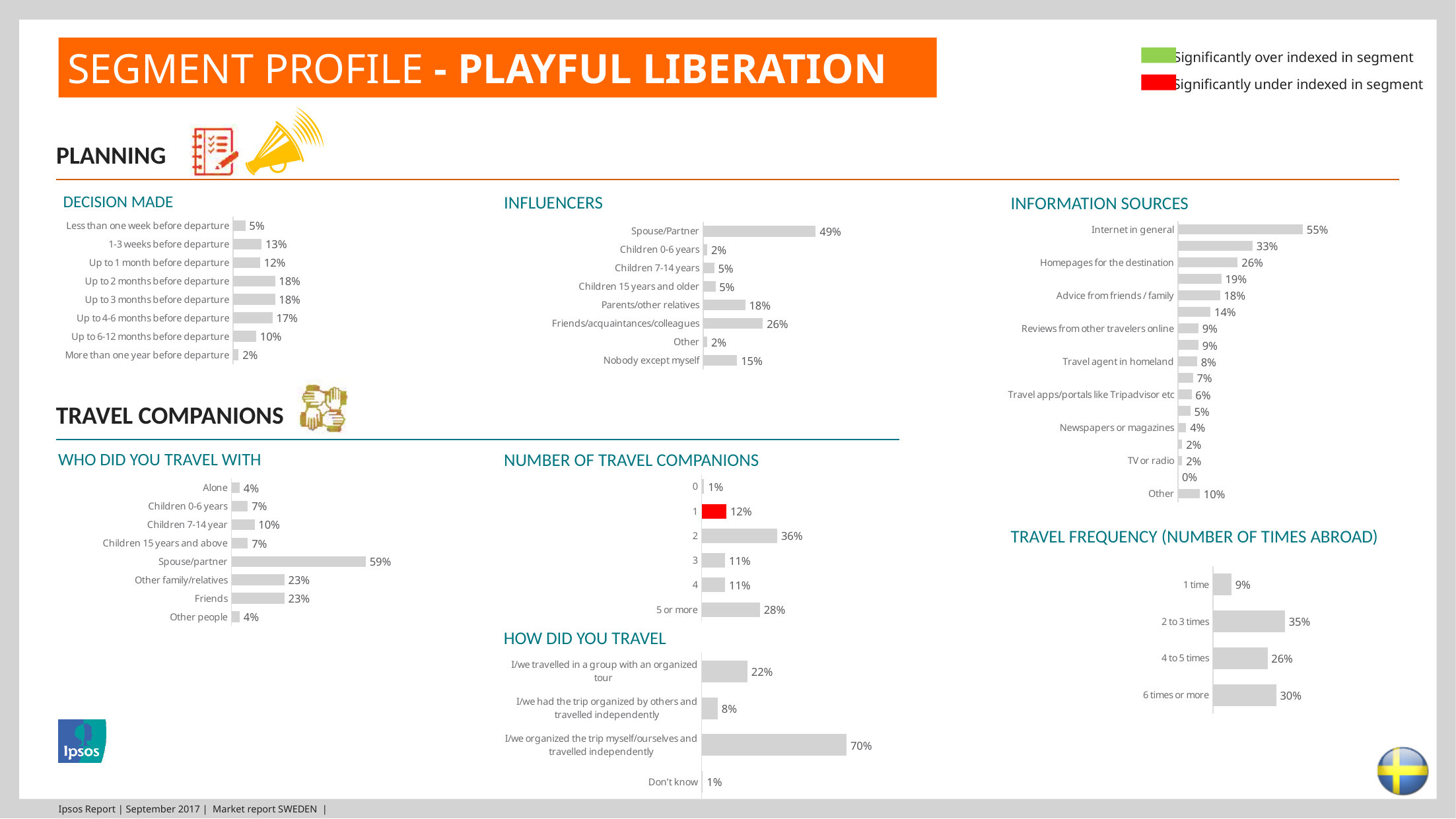
In the DECISION MADE chart, what percentage decided up to 2 months before departure? 18% In the HOW DID YOU TRAVEL chart, what percentage organized the trip themselves and travelled independently? 70% In the INFORMATION SOURCES chart, what is the value for Internet in general? 55% In the NUMBER OF TRAVEL COMPANIONS chart, which category has the highest value? 2 In the DECISION MADE chart, which category has the lowest value? More than one year before departure In the TRAVEL FREQUENCY chart, what is the difference between 2 to 3 times and 1 time? 26% In the INFORMATION SOURCES chart, which is larger: Advice from friends / family or Travel agent in homeland? Advice from friends / family How many categories does the WHO DID YOU TRAVEL WITH chart show? 8 In the INFLUENCERS chart, what is the difference between Friends/acquaintances/colleagues and Parents/other relatives? 8% In the WHO DID YOU TRAVEL WITH chart, what percentage travelled with a Spouse/partner? 59% In the INFLUENCERS chart, which influencer has the highest value? Spouse/Partner In the NUMBER OF TRAVEL COMPANIONS chart, which bar is coloured red? 1